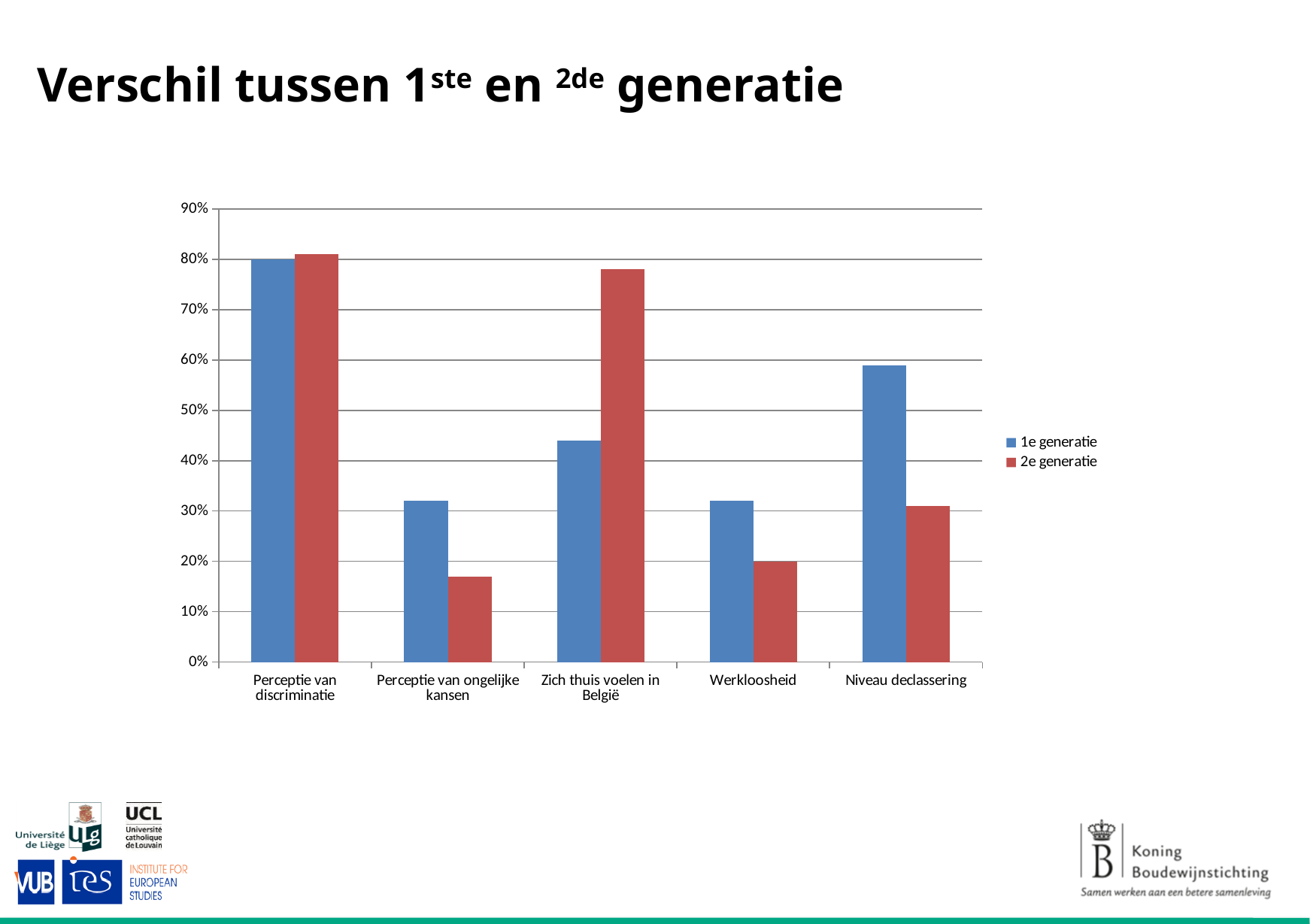
Is the value for 2e generatie in Niveau declassering greater or less than 40%? less Which colour represents 2e generatie in the chart? red Which category has the highest value for 1e generatie? Perceptie van discriminatie Is the value for 2e generatie in Zich thuis voelen in België greater or less than 70%? greater How many categories are shown on the x axis of the chart? 5 Is the value for 1e generatie in Niveau declassering greater or less than 50%? greater What kind of chart is shown on the slide? bar chart For Werkloosheid, which series has the larger value, 1e generatie or 2e generatie? 1e generatie For Niveau declassering, which series has the larger value, 1e generatie or 2e generatie? 1e generatie For Zich thuis voelen in België, which series has the larger value, 1e generatie or 2e generatie? 2e generatie How many series does the legend list? 2